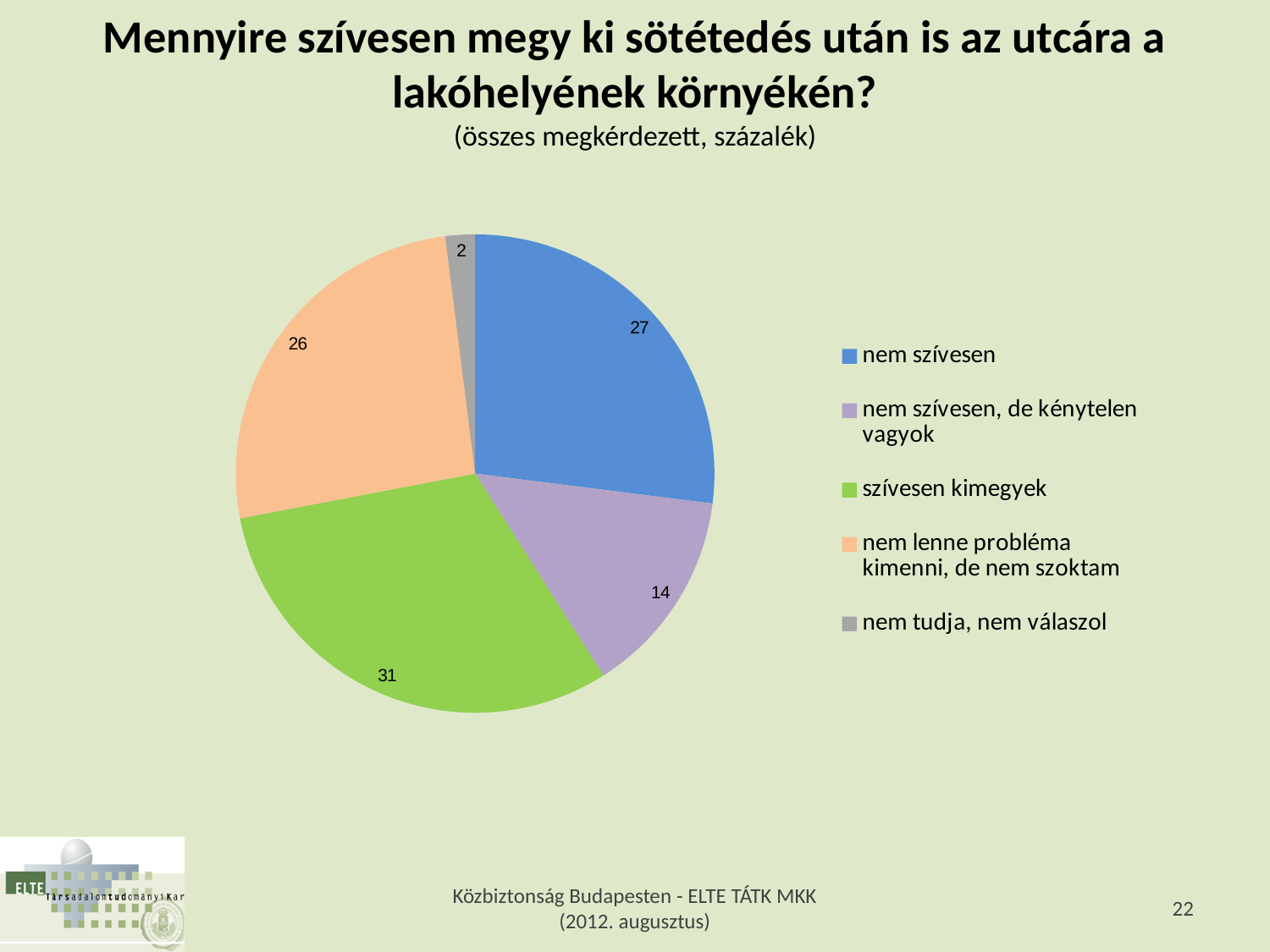
What is the value for "nem szívesen"? 27 What is the value for "nem tudja, nem válaszol"? 2 What is the value for "nem szívesen, de kénytelen vagyok"? 14 Which category has the smallest slice of the pie? nem tudja, nem válaszol What is the value for "szívesen kimegyek"? 31 What is the value for "nem lenne probléma kimenni, de nem szoktam"? 26 How many categories does the legend list? 5 What colour is the slice for "szívesen kimegyek"? green Which category has the largest slice of the pie? szívesen kimegyek What is the difference between the values for "szívesen kimegyek" and "nem szívesen, de kénytelen vagyok"? 17 Which is larger, the value for "nem szívesen" or the value for "nem lenne probléma kimenni, de nem szoktam"? nem szívesen What kind of chart is shown on the slide? pie chart